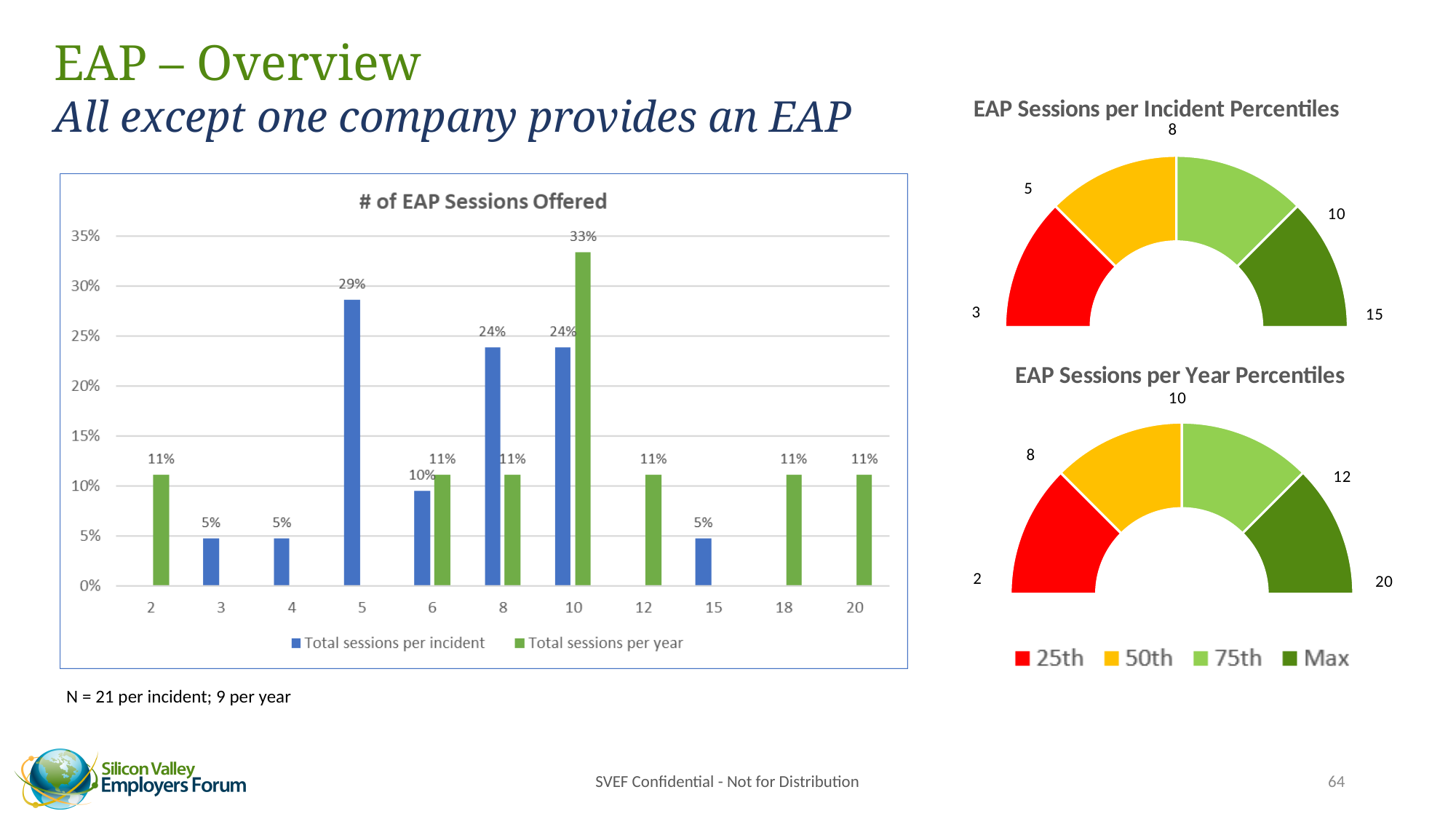
In the '# of EAP Sessions Offered' chart, how many series does the legend list? 2 In the '# of EAP Sessions Offered' chart, what is the value for Total sessions per year at 10 sessions? 33% In the '# of EAP Sessions Offered' chart, how many session categories are shown on the x axis? 11 In the '# of EAP Sessions Offered' chart, what is the value for Total sessions per incident at 6 sessions? 10% In the '# of EAP Sessions Offered' chart, what is the value for Total sessions per incident at 5 sessions? 29% What type of chart is '# of EAP Sessions Offered'? Bar chart What are the four legend entries shown below the 'EAP Sessions per Year Percentiles' chart? 25th, 50th, 75th, Max In the '# of EAP Sessions Offered' chart, which number of sessions has the highest value for Total sessions per year? 10 In the '# of EAP Sessions Offered' chart, which is larger at 8 sessions: Total sessions per incident or Total sessions per year? Total sessions per incident In the 'EAP Sessions per Year Percentiles' chart, what is the largest value labelled on the gauge? 20 In the '# of EAP Sessions Offered' chart, what is the difference between Total sessions per year and Total sessions per incident at 10 sessions? 9% In the '# of EAP Sessions Offered' chart, which number of sessions has the highest value for Total sessions per incident? 5